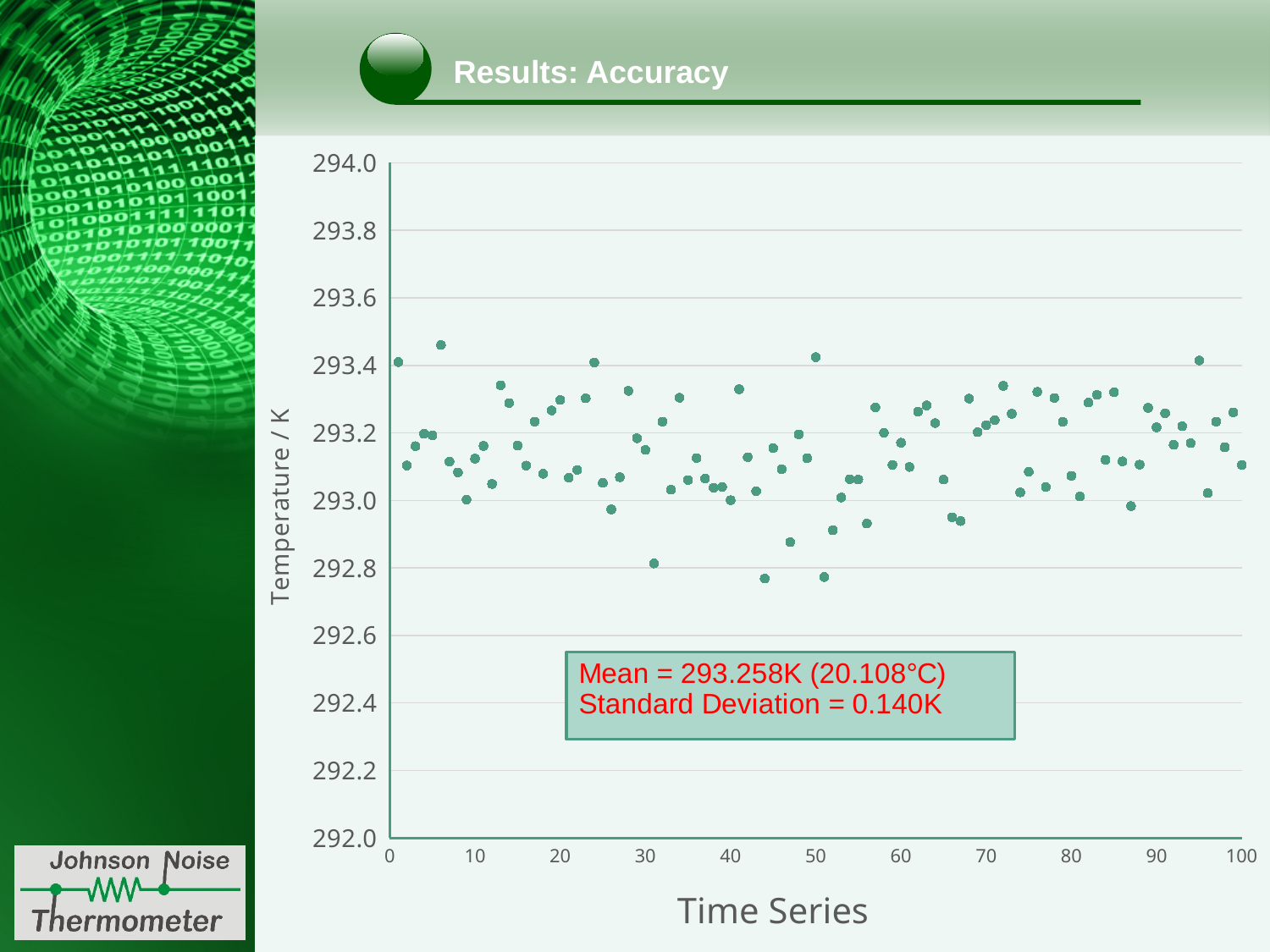
What kind of chart is shown on the slide? Scatter chart What is the title of the slide containing the chart? Results: Accuracy Is the highest plotted temperature greater or less than 293.6? less What is the maximum value shown on the horizontal axis? 100 What is the mean temperature in degrees Celsius stated on the chart? 20.108°C Do the plotted temperatures show a clear rising or falling trend along the time series? No, they fluctuate around a roughly constant level What is the maximum value shown on the vertical axis? 294.0 Is the first plotted point (near time 0) greater or less than 293.2? greater What mean temperature in kelvin is stated on the chart? 293.258K What standard deviation is stated on the chart? 0.140K Is the lowest plotted temperature greater or less than 293.0? less What is the label of the vertical axis of the chart? Temperature / K